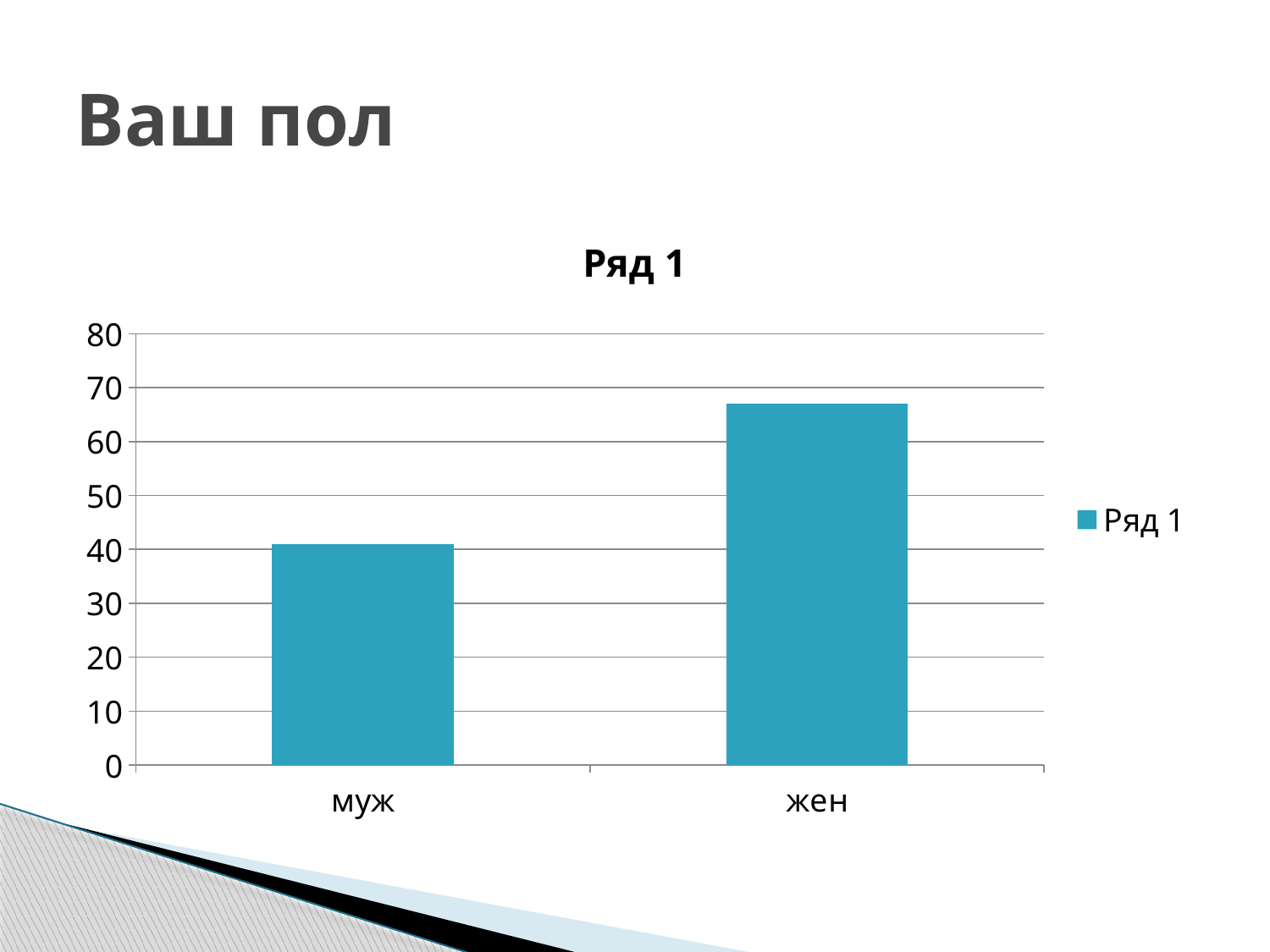
What is the name of the series listed in the chart's legend? Ряд 1 What kind of chart is shown on the slide? bar chart Is the value for муж greater or less than 50? less What is the title of the chart? Ряд 1 How many categories are shown on the x axis of the chart? 2 Is the value for жен greater or less than 60? greater Which category has the highest bar in the chart? жен Is the value for жен greater or less than 70? less How many series does the chart's legend list? 1 Which category has the lowest bar in the chart? муж Which is larger, the value for муж or the value for жен? жен